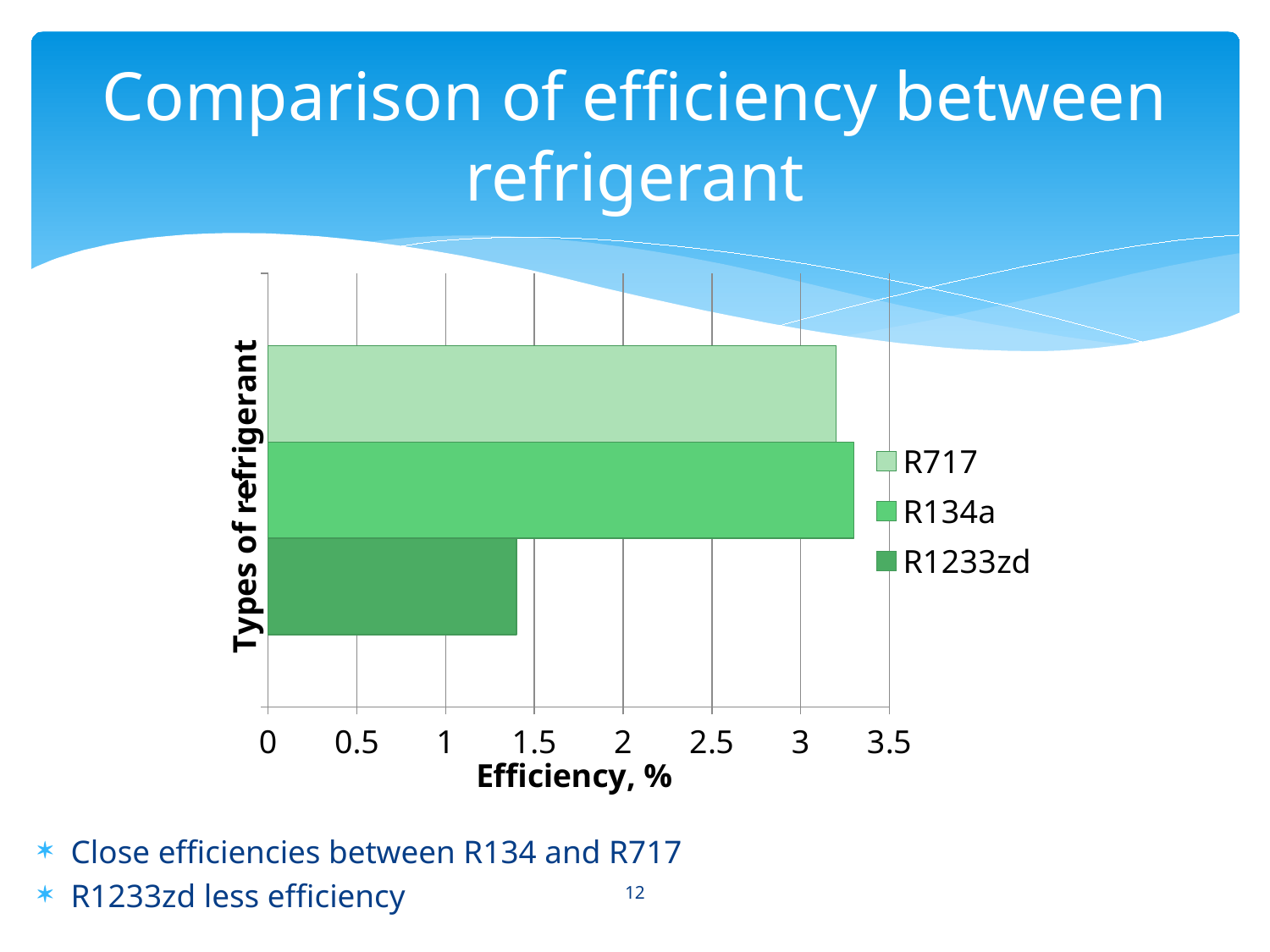
Which has the larger efficiency, R134a or R1233zd? R134a Is the efficiency value for R717 greater or less than 3? greater Which refrigerant has the lowest efficiency in the chart? R1233zd How many bars are plotted in the chart? 3 Which has the larger efficiency, R717 or R1233zd? R717 Is the efficiency value for R134a greater or less than 3? greater What is the label of the vertical axis of the chart? Types of refrigerant Is the efficiency value for R1233zd greater or less than 1? greater What is the label of the horizontal axis of the chart? Efficiency, % How many series does the legend list? 3 What kind of chart is shown on the slide? bar chart